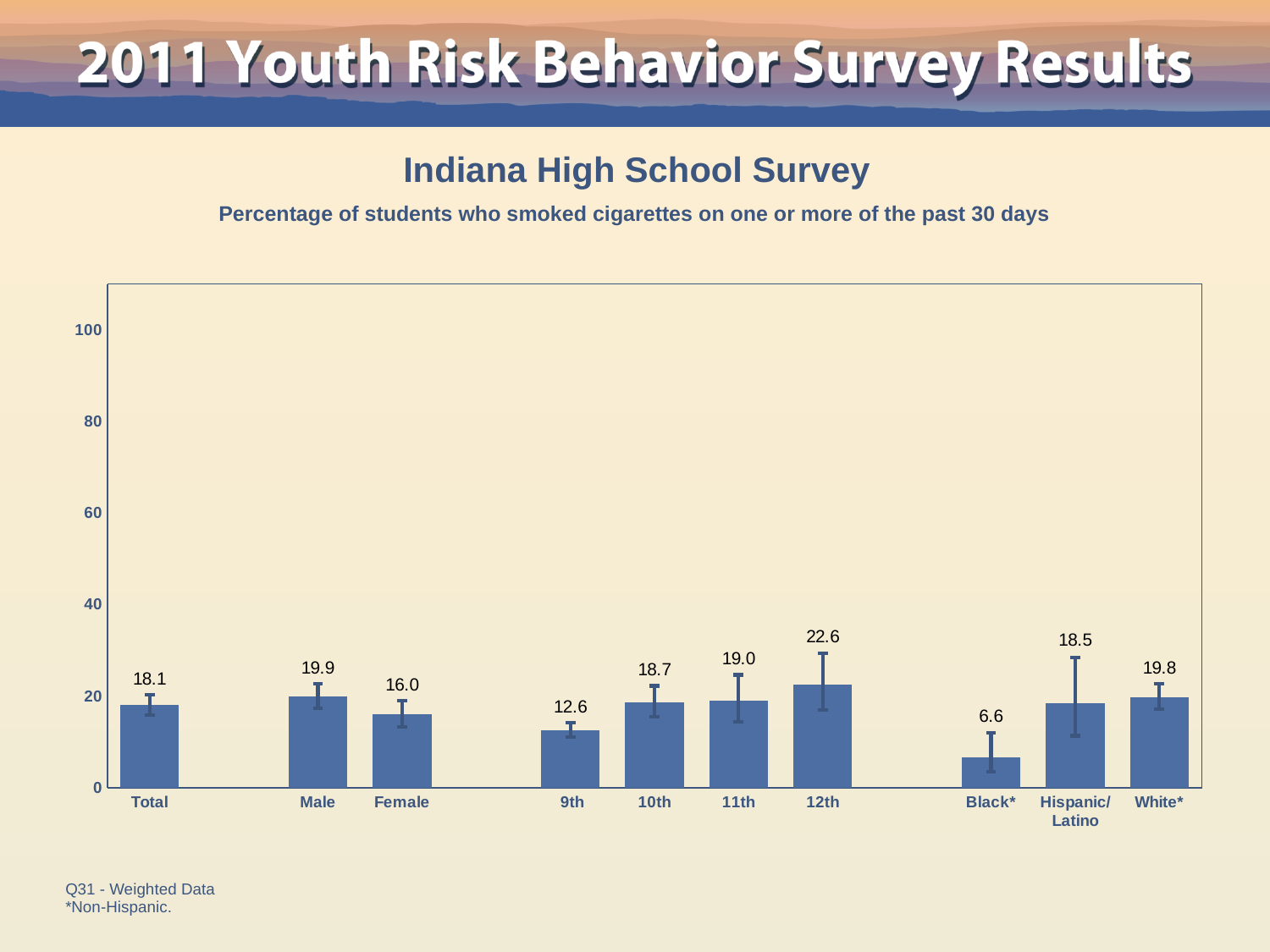
Which category has the highest value? 12th How many categories are shown on the x axis? 10 What is the subtitle describing the measure plotted in the chart? Percentage of students who smoked cigarettes on one or more of the past 30 days Is the value for White* greater or less than 40? less What is the value for 12th grade? 22.6 What is the value for Total? 18.1 Do the values rise or fall from 9th grade to 12th grade? rise What kind of chart is this? bar chart Which is larger, the value for 9th or the value for 10th? 10th What is the value for Hispanic/Latino students? 18.5 What is the difference between the Male and Female values? 3.9 Which category has the lowest value? Black*